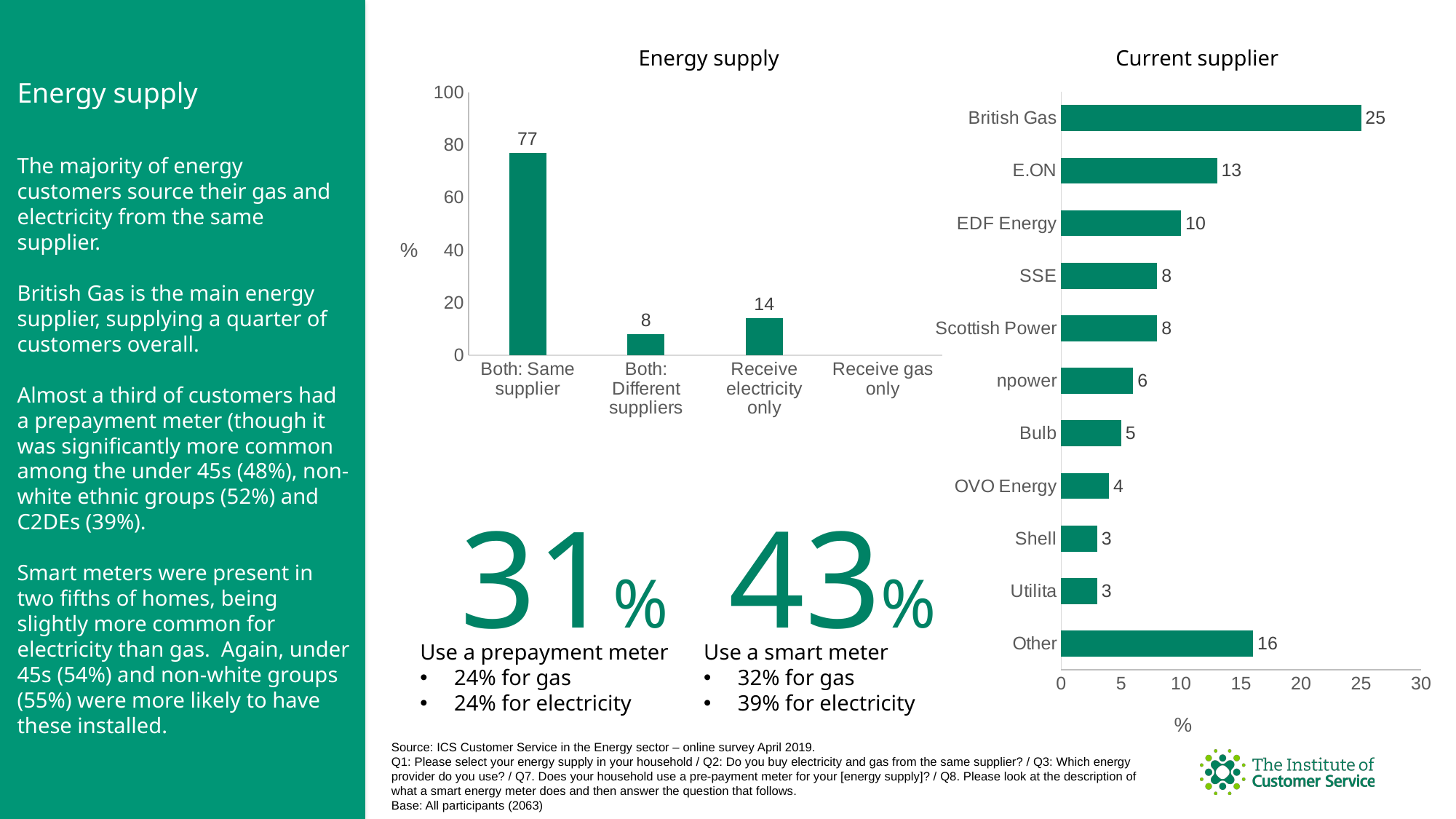
In the "Current supplier" chart, which named supplier (excluding Other) has the highest value? British Gas In the "Current supplier" chart, which is larger, E.ON or EDF Energy? E.ON In the "Energy supply" chart, what is the difference between "Both: Same supplier" and "Both: Different suppliers"? 69 In the "Current supplier" chart, how many categories are shown? 11 What type of chart is the "Energy supply" chart? Bar chart In the "Current supplier" chart, what is the label on the horizontal axis? % In the "Current supplier" chart, what is the value for npower? 6 In the "Current supplier" chart, what is the difference between British Gas and Other? 9 In the "Energy supply" chart, what is the value for "Both: Same supplier"? 77 In the "Energy supply" chart, which category has the highest value? Both: Same supplier In the "Current supplier" chart, what is the value for British Gas? 25 In the "Energy supply" chart, what is the value for "Receive electricity only"? 14